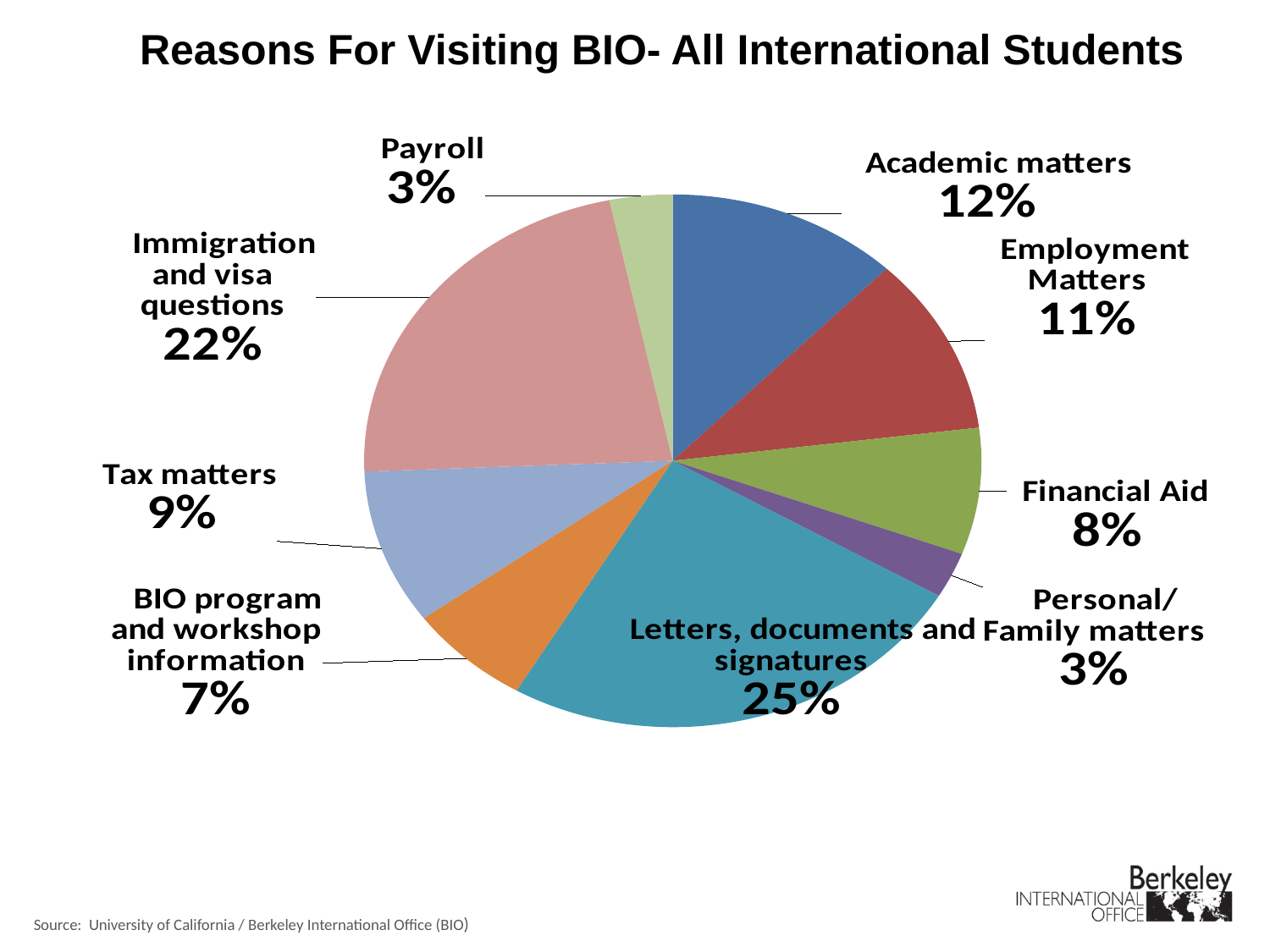
What kind of chart is shown on the slide? Pie chart What percentage is shown for Tax matters? 9% What is the title of the chart? Reasons For Visiting BIO- All International Students Which reason for visiting BIO has the largest share of the pie? Letters, documents and signatures What percentage is shown for Payroll? 3% What percentage is shown for Employment Matters? 11% What share of the pie is Immigration and visa questions? 22% How many slices does the pie chart have? 9 Which has a larger share, BIO program and workshop information or Tax matters? Tax matters What percentage is shown for Academic matters? 12% What share of the pie is Letters, documents and signatures? 25% What is the difference in percentage points between Immigration and visa questions and Financial Aid? 14